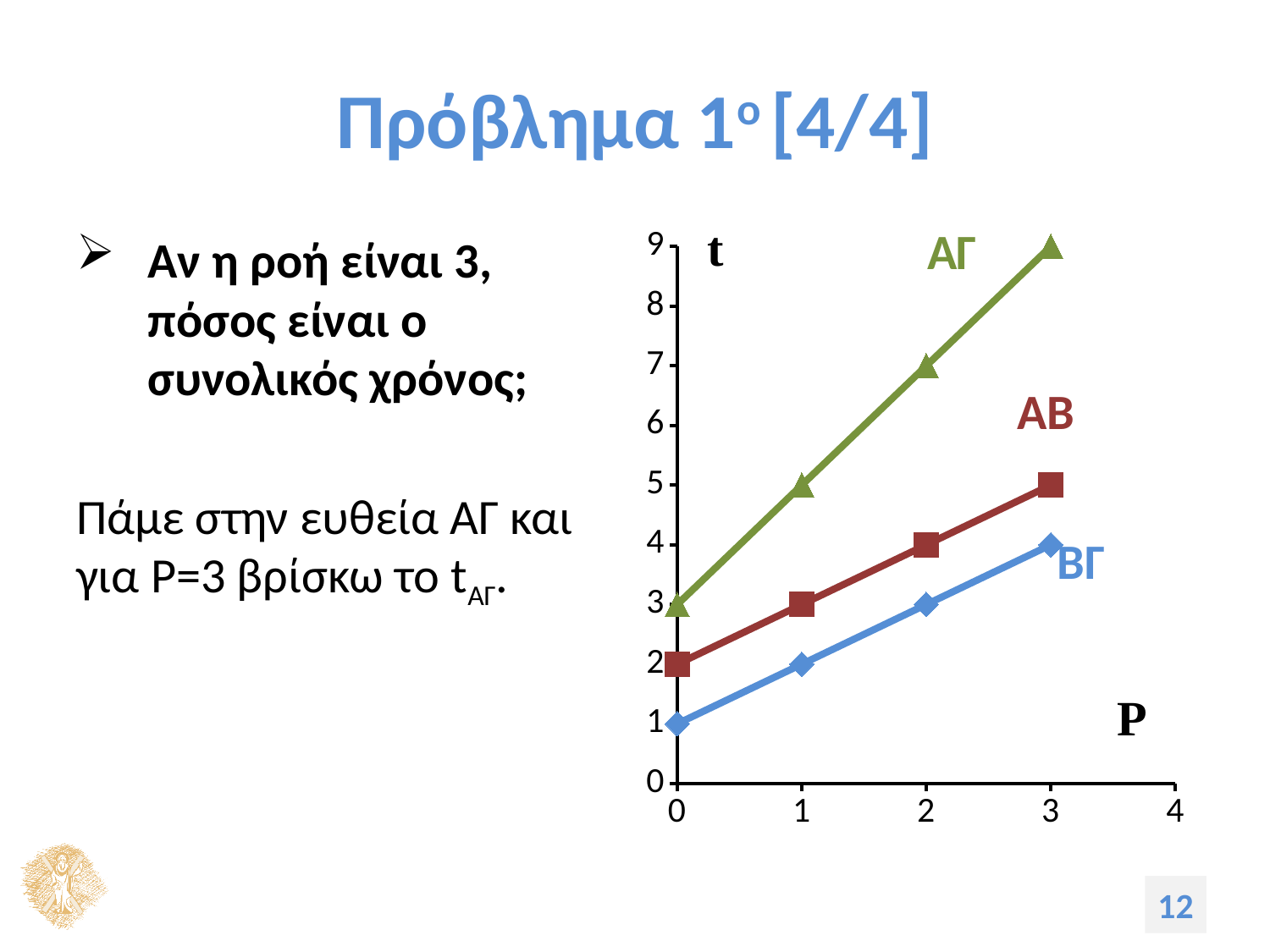
What is the difference between the ΑΓ and ΑΒ values of t at P=3? 4 What is the value of t for the ΑΓ line at P=3? 9 What is the value of t for the ΑΒ line at P=3? 5 Which line has the lowest value of t at P=0? ΒΓ What is the value of t for the ΒΓ line at P=0? 1 At P=2, which is larger: the t value of ΑΒ or of ΒΓ? ΑΒ Do the values of t rise or fall as P increases along the ΑΓ line? rise Which line has the highest value of t at P=3? ΑΓ How many data points are plotted on each line? 4 How many lines (series) are plotted on the chart? 3 What is the value of t for the ΑΓ line at P=1? 5 What kind of chart is shown on the slide? line chart